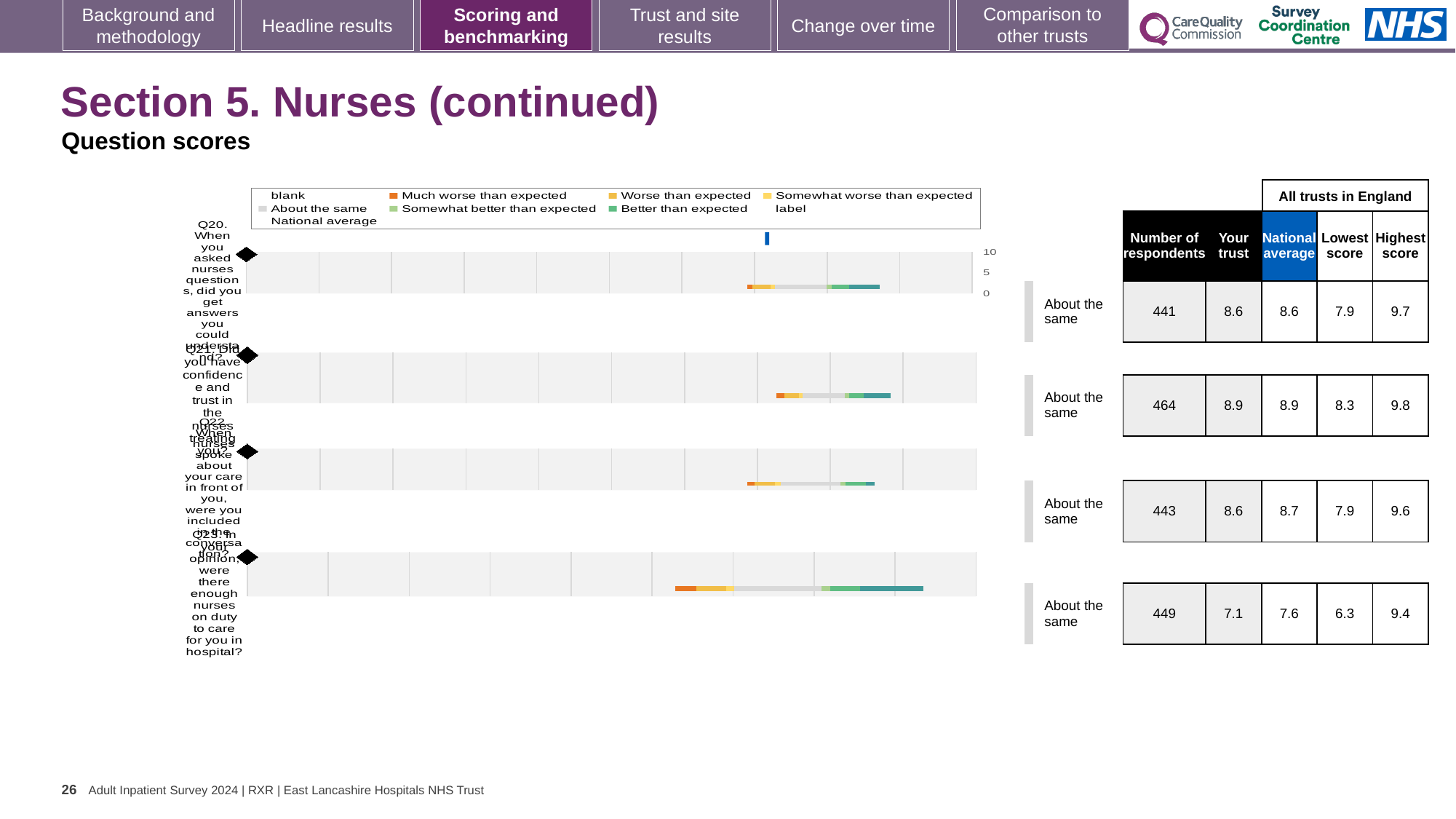
Which question has the highest 'Your trust' score? Q21 For Q23, how much higher is the national average than the 'Your trust' score? 0.5 Which question has the lowest 'Your trust' score? Q23 How many questions (Q20 to Q23) are plotted on the chart? 4 What is the national average score for Q22 (nurses speaking about your care in front of you)? 8.7 What kind of chart is used to show the question scores on this slide? bar chart What is the lowest score across all trusts in England for Q23? 6.3 Which has the higher 'Your trust' score, Q20 or Q23? Q20 How many respondents answered Q21 (confidence and trust in the nurses)? 464 What benchmark category is shown for Q23? About the same What is the 'Your trust' score for Q23 (were there enough nurses on duty)? 7.1 What is the highest score across all trusts in England for Q21? 9.8